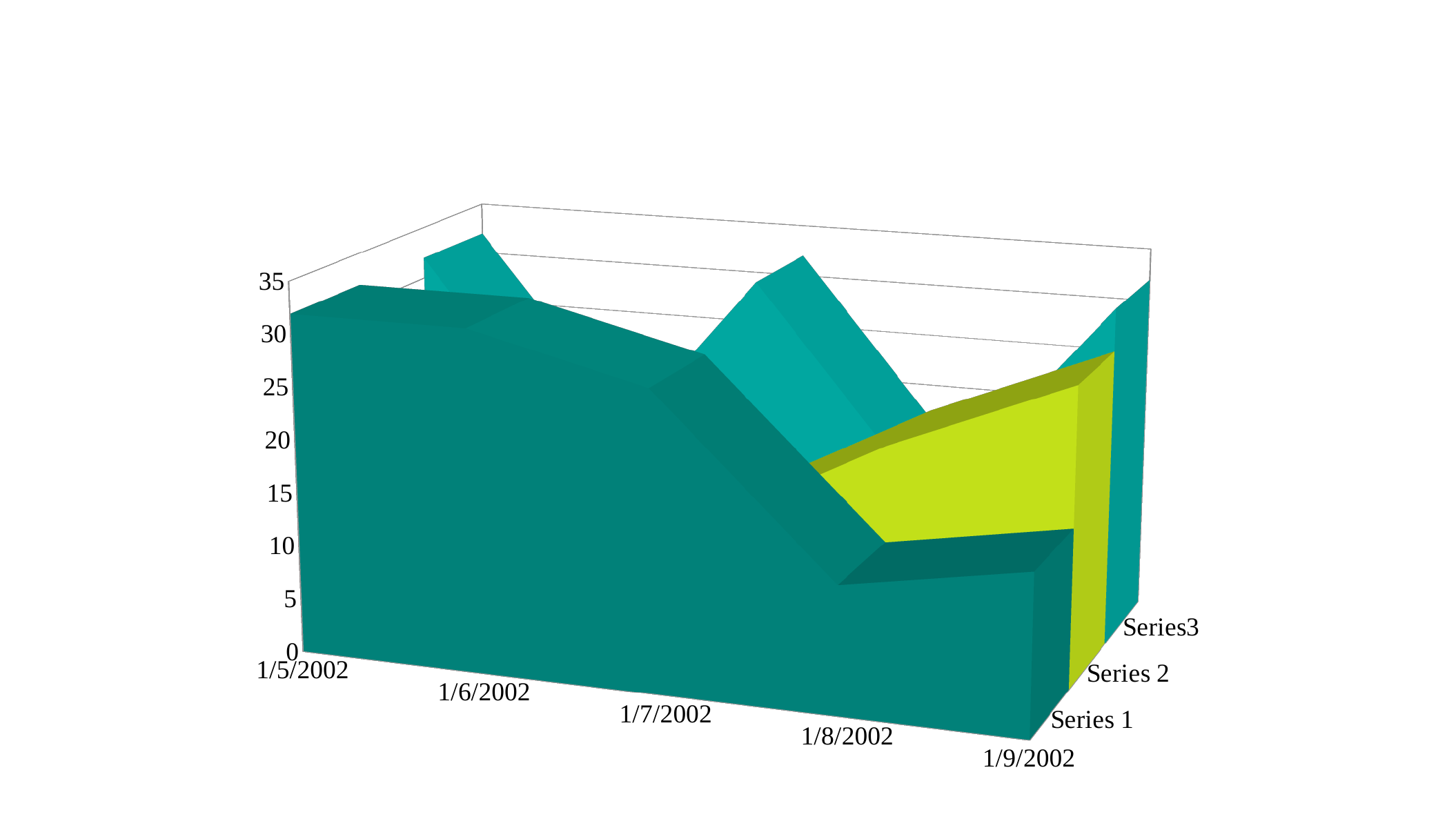
Is the value for Series 1 at 1/5/2002 greater or less than 25? greater How many series does the chart plot? 3 Which is larger for Series 1: the value at 1/5/2002 or the value at 1/8/2002? 1/5/2002 What is the highest value shown on the vertical axis? 35 Is the value for Series 1 at 1/8/2002 greater or less than 20? less How many dates are shown along the x axis of the chart? 5 What is the last date shown on the x axis? 1/9/2002 What is the first date shown on the x axis? 1/5/2002 Does Series 1 rise or fall from 1/6/2002 to 1/8/2002? Fall What kind of chart is shown on the slide? Area chart